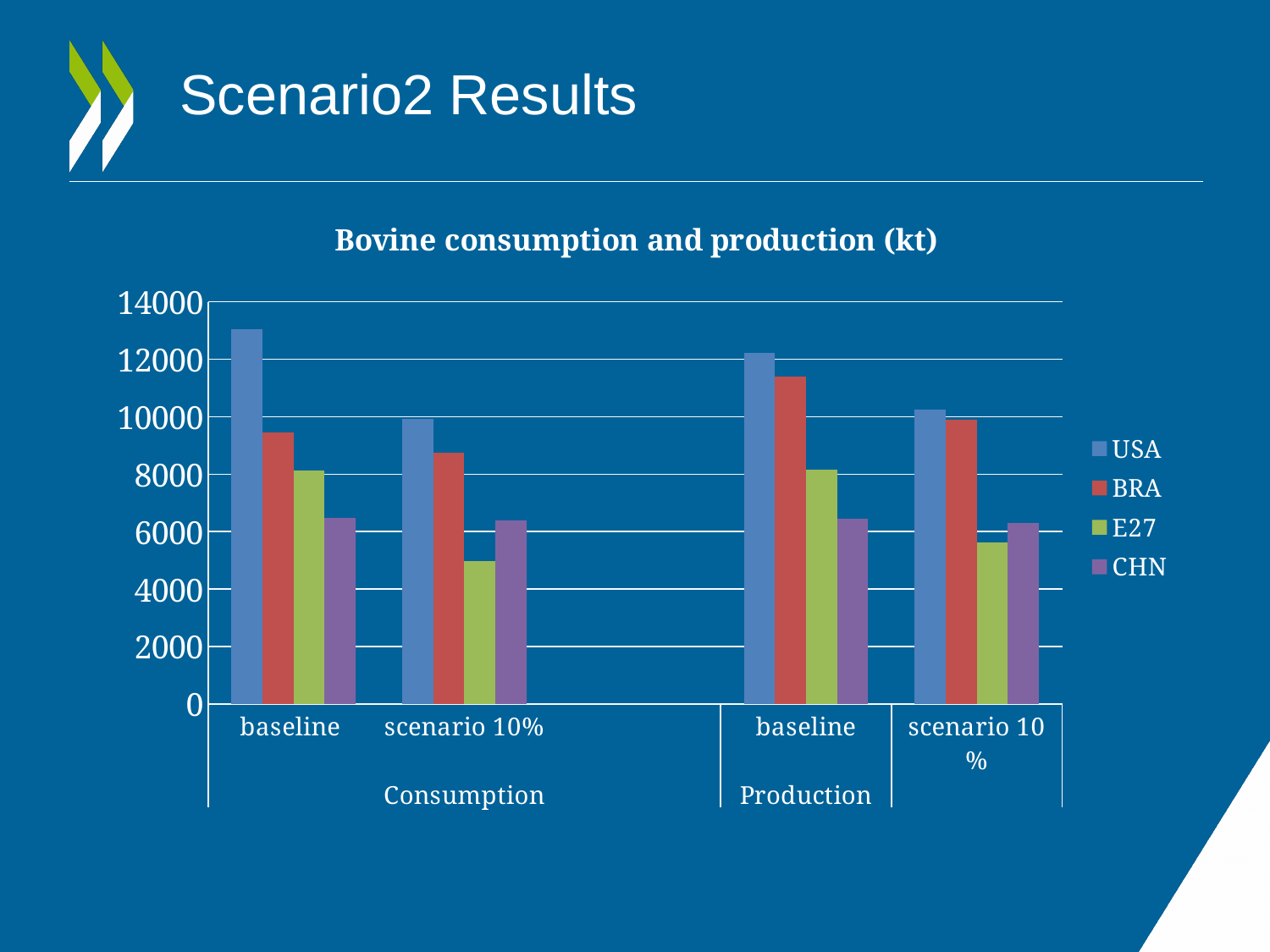
Which is larger, the USA value for Consumption baseline or the USA value for Consumption scenario 10%? Consumption baseline Is the BRA value for Production baseline greater or less than 10000? greater Does the E27 value rise or fall from Production baseline to Production scenario 10%? fall Which series has the lowest value in the Consumption scenario 10% group? E27 What is the title of the chart? Bovine consumption and production (kt) What kind of chart is shown on the slide? bar chart Is the USA value for Consumption baseline greater or less than 12000? greater Is the E27 value for Consumption scenario 10% greater or less than 6000? less How many series does the legend list? 4 Which is larger in the Production scenario 10% group, the E27 value or the CHN value? CHN Which series is shown in green in the legend? E27 Which series has the highest value in the Consumption baseline group? USA